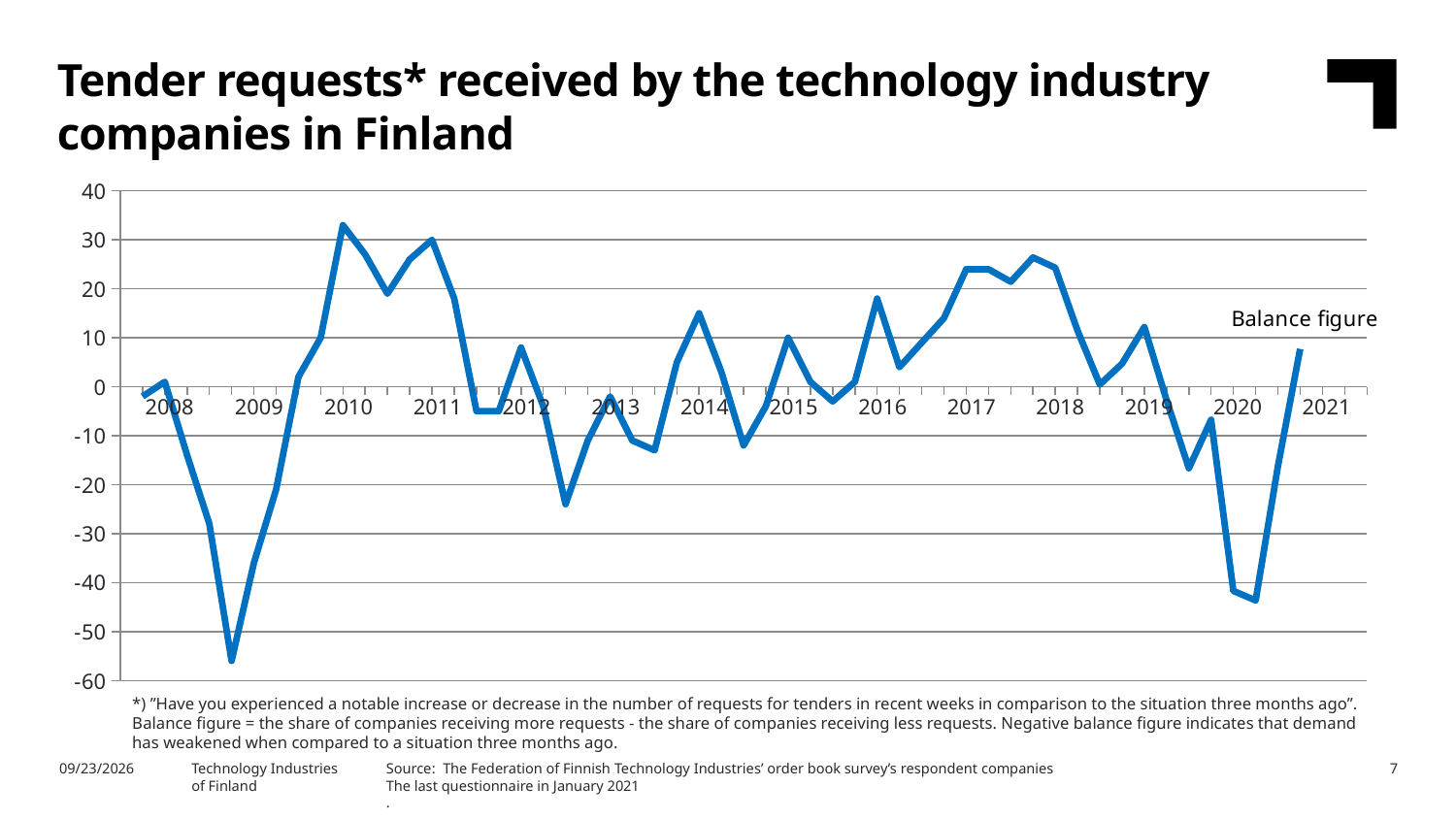
What is the title of the chart on the slide? Tender requests* received by the technology industry companies in Finland What kind of chart is shown on the slide? line chart Is the lowest value of the balance figure in 2020 greater or less than -40? less Which is lower: the trough of the balance figure in 2009 or the trough in 2020? 2009 Is the peak value of the balance figure in 2017 greater or less than 20? greater How many year labels are shown on the x axis? 14 Does the balance figure rise or fall between the end of 2020 and the start of 2021? rise What is the name of the series shown in the chart? Balance figure Is the lowest value of the balance figure in 2009 greater or less than -50? less In which year does the balance figure reach its lowest point? 2009